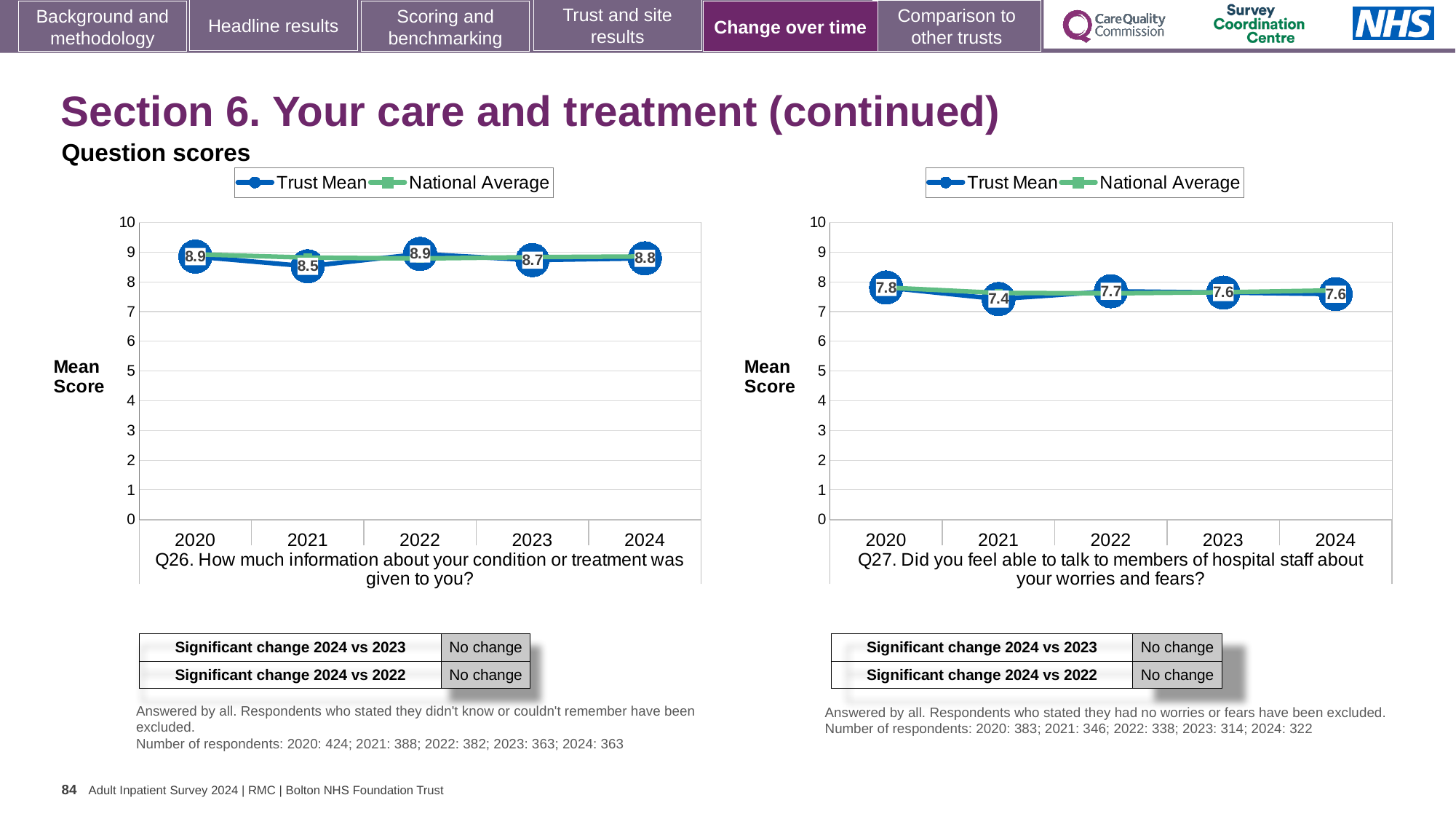
In the Q27 chart on the right, what is the Trust Mean score for 2020? 7.8 In the Q27 chart on the right, which year has the highest Trust Mean score? 2020 In the Q26 chart on the left, is the Trust Mean score higher in 2023 or 2024? 2024 How many series does the legend of the Q27 chart on the right list? 2 How many years are plotted on the x axis of the Q26 chart on the left? 5 What kind of chart is the Q26 chart on the left? Line chart In the Q27 chart on the right, what is the difference between the Trust Mean scores for 2020 and 2021? 0.4 In the Q26 chart on the left, what is the Trust Mean score for 2021? 8.5 In the Q26 chart on the left, which year has the lowest Trust Mean score? 2021 In the Q27 chart on the right, which year has the lowest Trust Mean score? 2021 In the Q27 chart on the right, is the Trust Mean score for 2021 greater or less than 8? less In the Q26 chart on the left, what is the difference between the Trust Mean scores for 2022 and 2021? 0.4